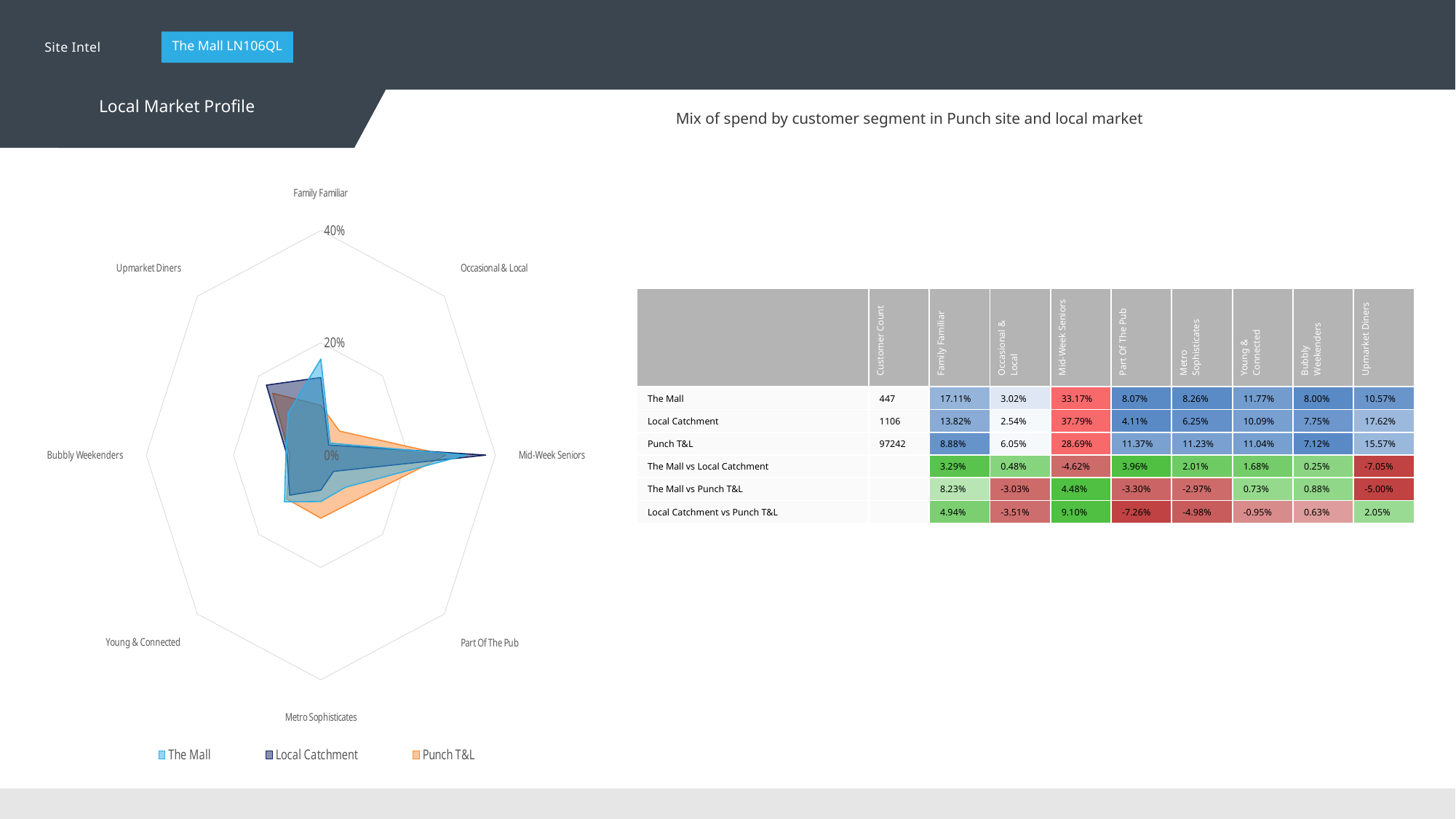
What colour represents Punch T&L in the radar chart legend? orange What is the Local Catchment value for Mid-Week Seniors? 37.79% What is the Punch T&L value for Part Of The Pub? 11.37% Is the value for Punch T&L in Family Familiar greater or less than 20%? less How many customer segments are plotted around the radar chart? 8 Which customer segment has the highest value for The Mall? Mid-Week Seniors Which customer segment has the lowest value for The Mall? Occasional & Local Is the value for The Mall in Mid-Week Seniors greater or less than 20%? greater For Mid-Week Seniors, which is larger: The Mall or Local Catchment? Local Catchment What kind of chart is shown on the left of the slide? radar chart What is the difference between The Mall and Local Catchment for Family Familiar? 3.29% How many series does the legend of the radar chart list? 3